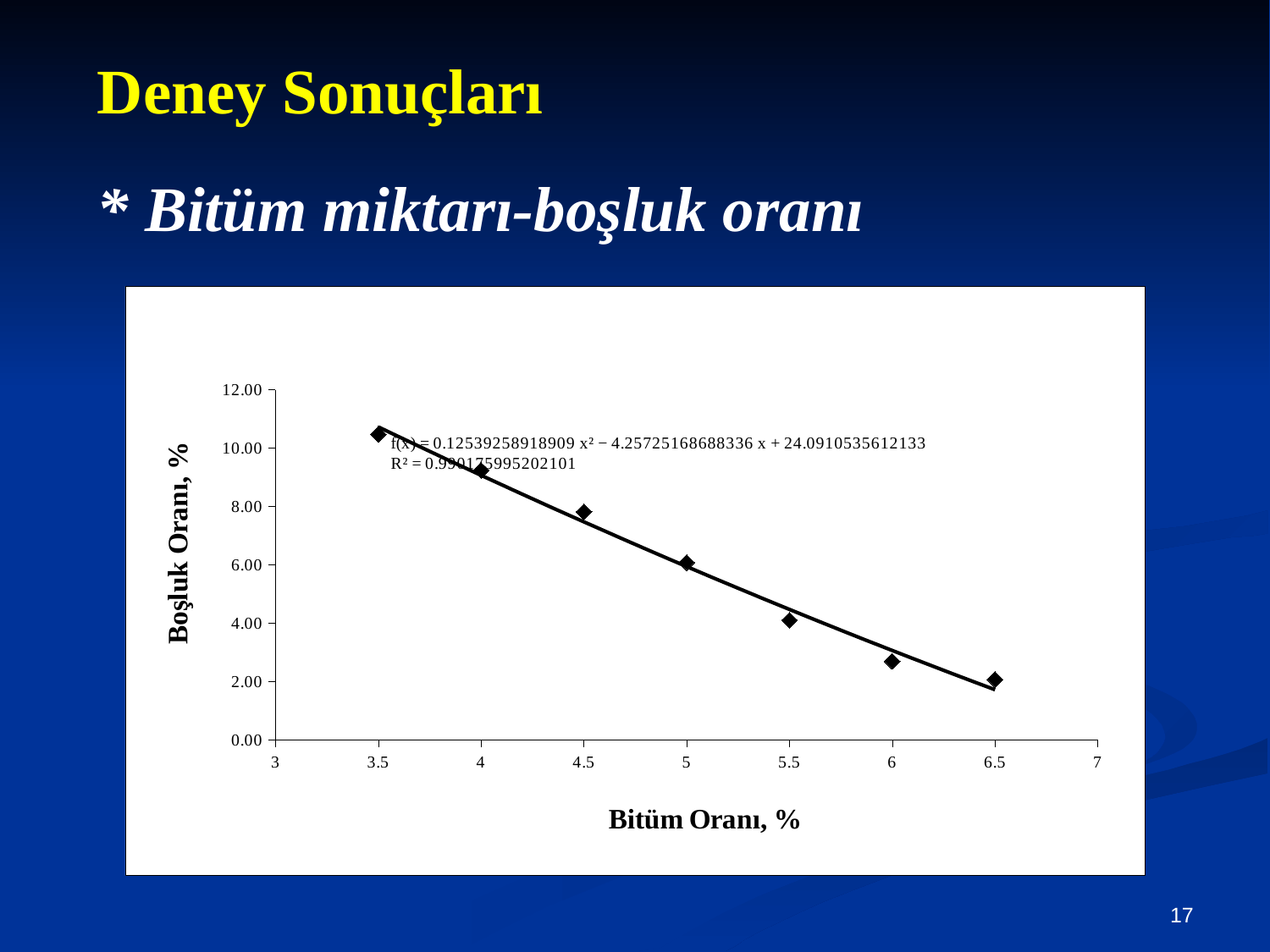
Is the Boşluk Oranı value at Bitüm Oranı 5 greater or less than 4.00? greater Which has the larger Boşluk Oranı value: Bitüm Oranı 4 or Bitüm Oranı 5? 4 Is the Boşluk Oranı value at Bitüm Oranı 5.5 greater or less than 6.00? less At which Bitüm Oranı value is Boşluk Oranı lowest? 6.5 How many data points are plotted on the chart? 7 At which Bitüm Oranı value is Boşluk Oranı highest? 3.5 Is the Boşluk Oranı value at Bitüm Oranı 6.5 greater or less than 4.00? less Do the values of Boşluk Oranı rise or fall as Bitüm Oranı increases along the x axis? Fall What is the title of the x axis of the chart? Bitüm Oranı, % What kind of chart is shown on the slide? Scatter chart with a trendline